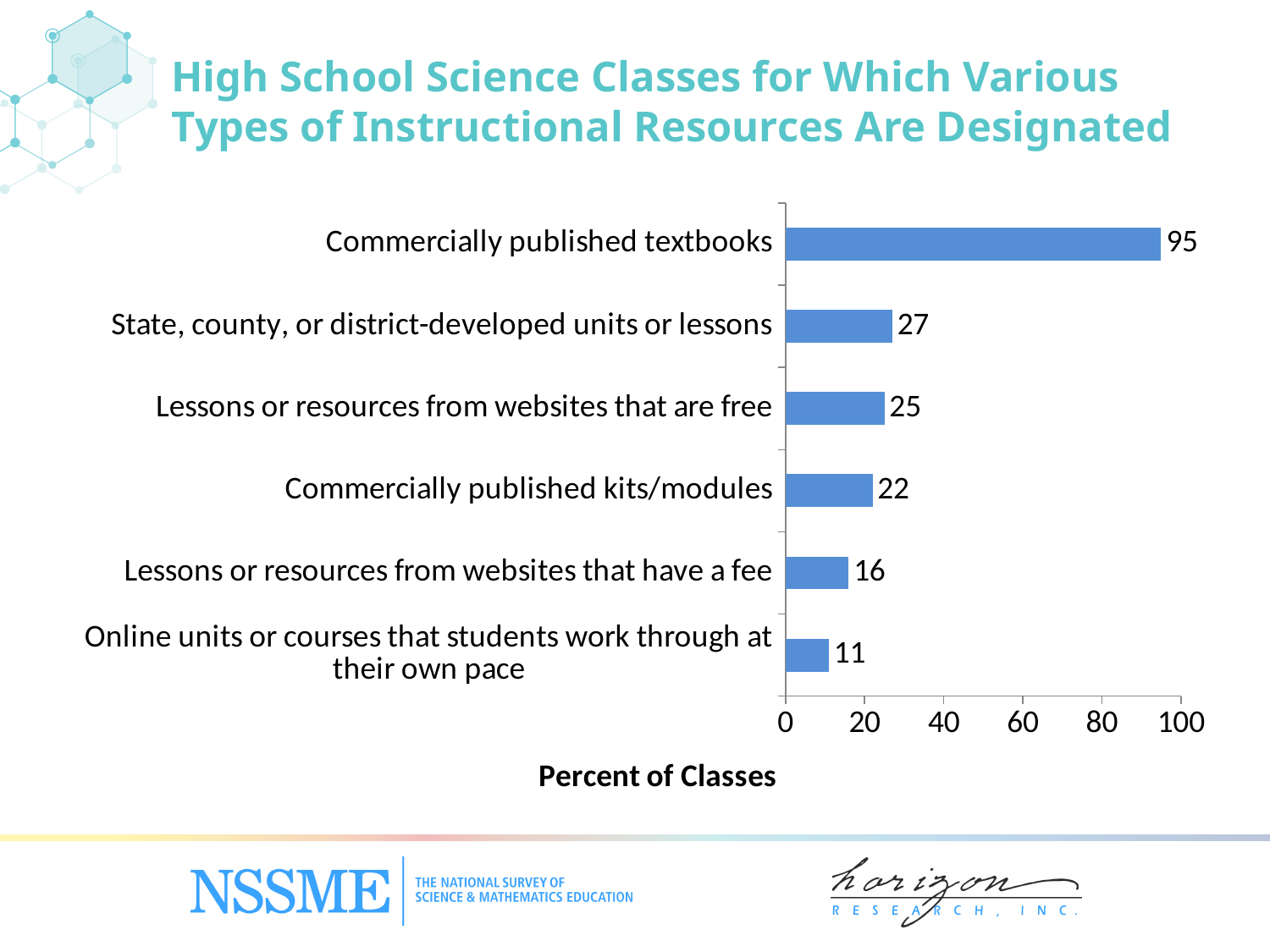
How many types of instructional resources are shown in the chart? 6 Which is larger: the value for lessons or resources from websites that are free or the value for lessons or resources from websites that have a fee? Lessons or resources from websites that are free What is the value for lessons or resources from websites that have a fee? 16 What is the difference between the values for state, county, or district-developed units or lessons and lessons or resources from websites that are free? 2 Which type of instructional resource has the highest percent of classes? Commercially published textbooks Which type of instructional resource has the lowest percent of classes? Online units or courses that students work through at their own pace What is the value for online units or courses that students work through at their own pace? 11 What kind of chart is shown on the slide? Bar chart Is the value for commercially published kits/modules greater or less than 40? less What is the label of the horizontal axis? Percent of Classes What percent of classes have commercially published textbooks designated? 95 What is the difference between the values for commercially published textbooks and commercially published kits/modules? 73